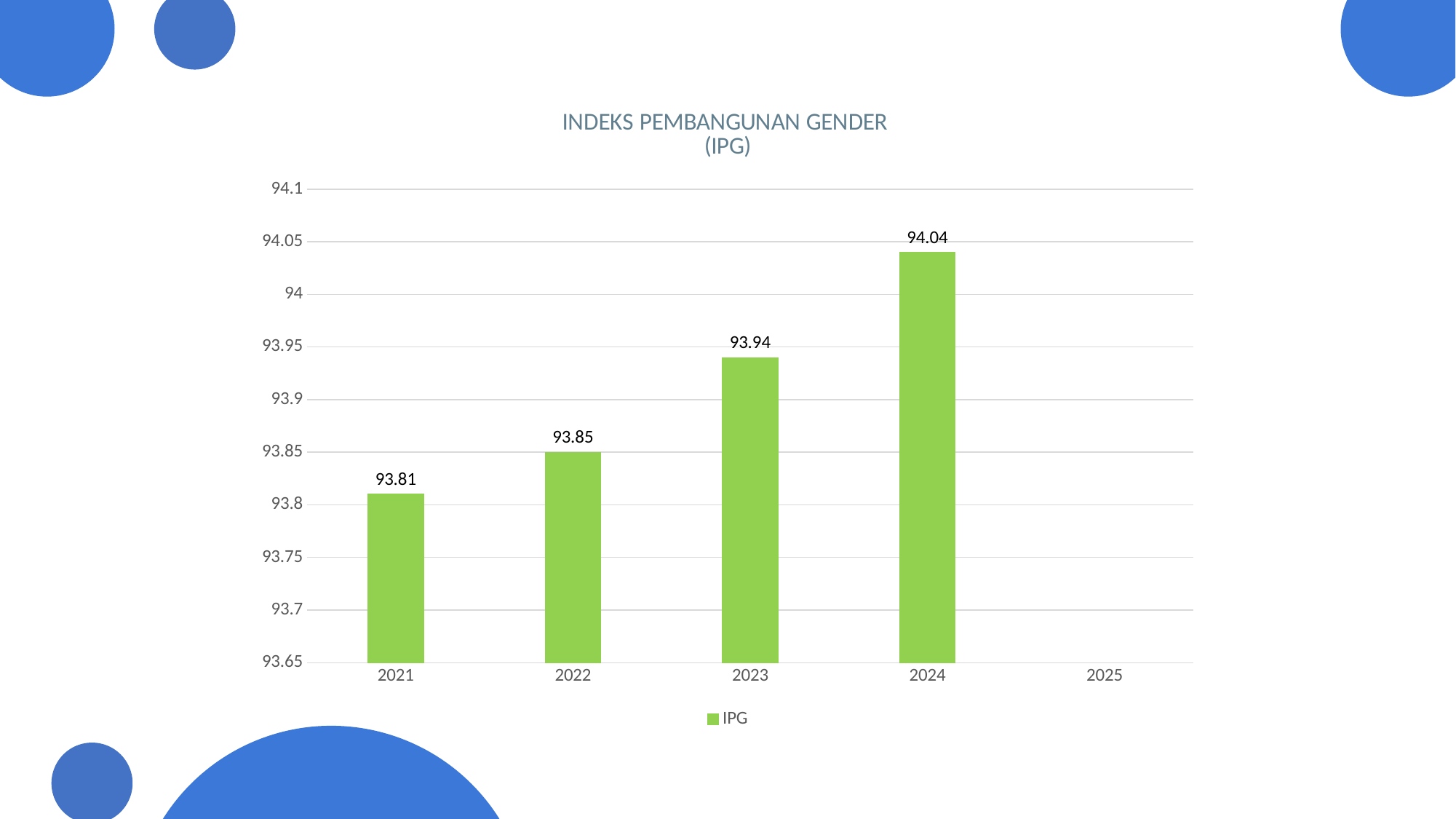
What is the IPG value for 2023? 93.94 Which year with a plotted bar has the lowest IPG value? 2021 Do the IPG values rise or fall from 2021 to 2024? rise How many years are shown on the x axis? 5 What is the IPG value for 2021? 93.81 What is the difference between the IPG values for 2023 and 2022? 0.09 Which year has the highest IPG value? 2024 Is the IPG value for 2024 greater or less than 94? greater What kind of chart is shown on the slide? bar chart What is the difference between the IPG values for 2024 and 2021? 0.23 What is the IPG value for 2024? 94.04 Which is larger, the IPG value for 2022 or for 2023? 2023